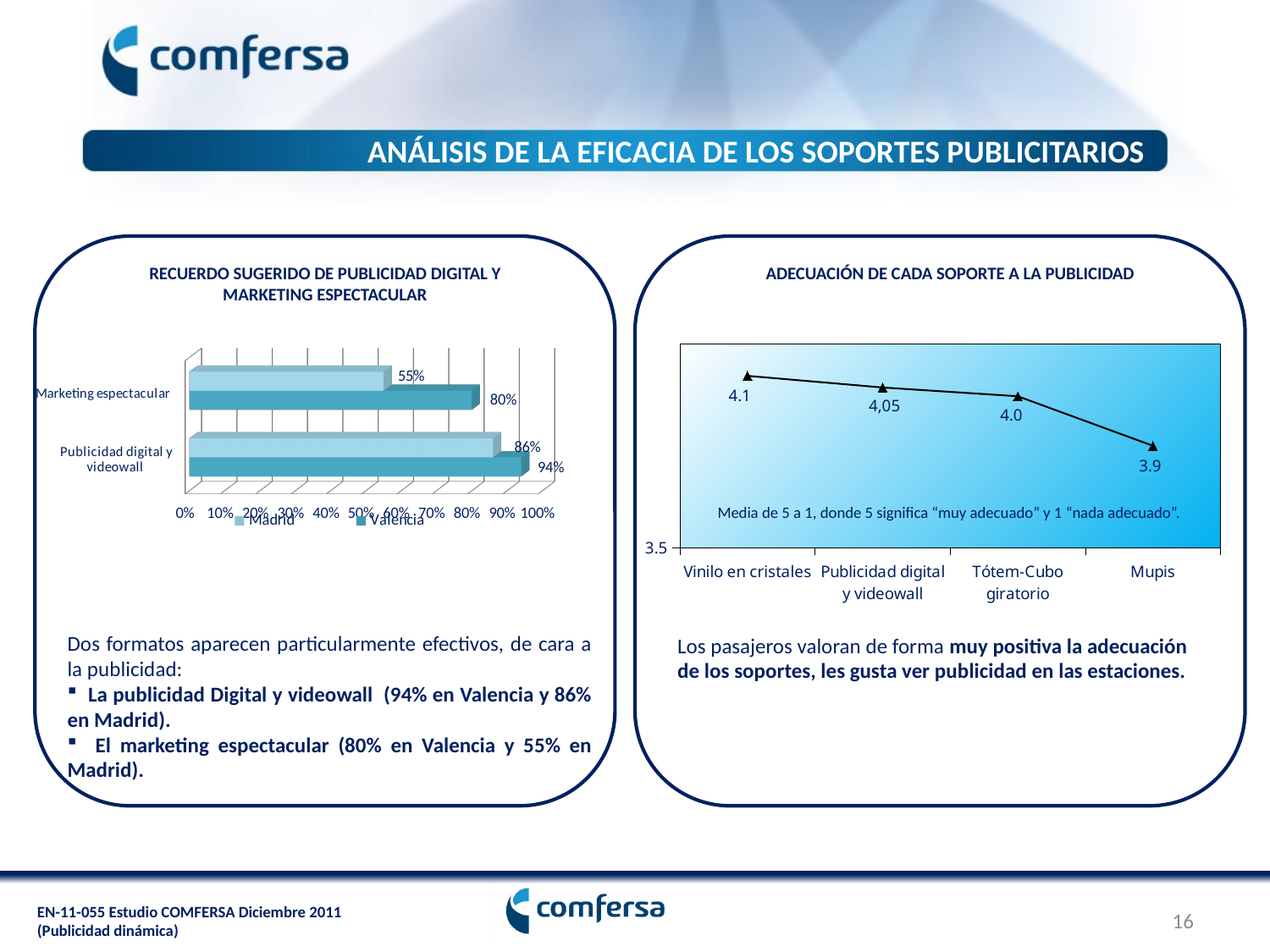
In the chart titled 'ADECUACIÓN DE CADA SOPORTE A LA PUBLICIDAD', do the values rise or fall from left to right along the x axis? Fall In the chart titled 'RECUERDO SUGERIDO DE PUBLICIDAD DIGITAL Y MARKETING ESPECTACULAR', what is the value for Madrid for Marketing espectacular? 55% In the chart titled 'ADECUACIÓN DE CADA SOPORTE A LA PUBLICIDAD', how many categories are plotted? 4 In the chart titled 'RECUERDO SUGERIDO DE PUBLICIDAD DIGITAL Y MARKETING ESPECTACULAR', how many series does the legend list? 2 In the chart titled 'RECUERDO SUGERIDO DE PUBLICIDAD DIGITAL Y MARKETING ESPECTACULAR', what is the difference between the Valencia and Madrid values for Marketing espectacular? 25% In the chart titled 'ADECUACIÓN DE CADA SOPORTE A LA PUBLICIDAD', which category has the highest value? Vinilo en cristales In the chart titled 'ADECUACIÓN DE CADA SOPORTE A LA PUBLICIDAD', which category has the lowest value? Mupis In the chart titled 'ADECUACIÓN DE CADA SOPORTE A LA PUBLICIDAD', what is the value for Mupis? 3.9 In the chart titled 'RECUERDO SUGERIDO DE PUBLICIDAD DIGITAL Y MARKETING ESPECTACULAR', which series is shown in the darker blue colour? Valencia In the chart titled 'RECUERDO SUGERIDO DE PUBLICIDAD DIGITAL Y MARKETING ESPECTACULAR', what is the value for Valencia for Publicidad digital y videowall? 94% In the chart titled 'RECUERDO SUGERIDO DE PUBLICIDAD DIGITAL Y MARKETING ESPECTACULAR', which is larger for Publicidad digital y videowall: Madrid or Valencia? Valencia What kind of chart is the one titled 'RECUERDO SUGERIDO DE PUBLICIDAD DIGITAL Y MARKETING ESPECTACULAR'? Bar chart